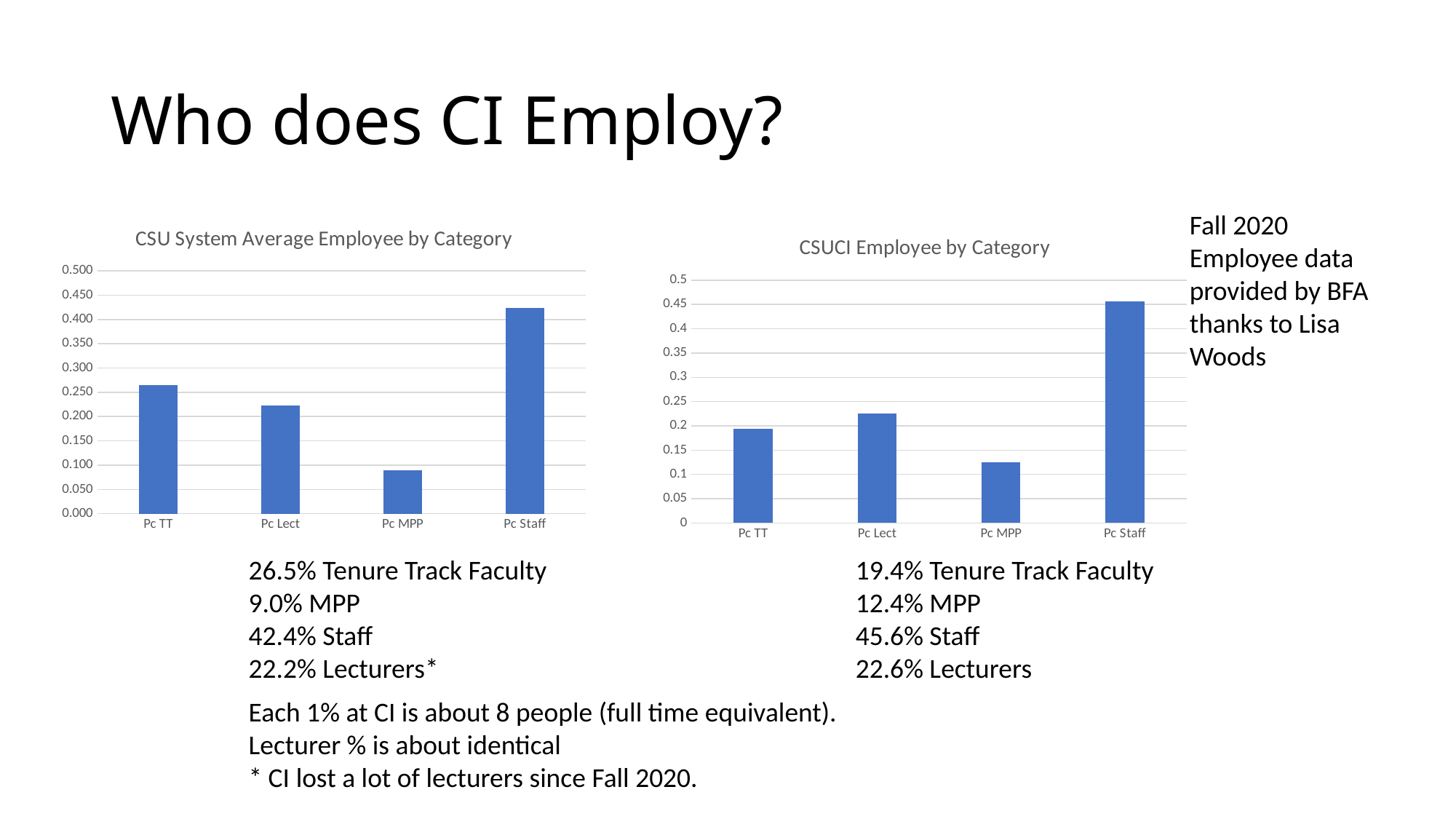
In the CSU System Average Employee by Category chart, which category has the lowest value? Pc MPP How many categories are shown in the CSUCI Employee by Category chart? 4 In the CSU System Average Employee by Category chart, which is larger, the value for Pc TT or the value for Pc Lect? Pc TT In the CSUCI Employee by Category chart, which is larger, the value for Pc TT or the value for Pc Lect? Pc Lect What type of chart is the CSU System Average Employee by Category chart? bar chart In the CSU System Average Employee by Category chart, is the value for Pc Staff greater or less than 0.400? greater In the CSU System Average Employee by Category chart, which category has the highest value? Pc Staff In the CSUCI Employee by Category chart, which category has the lowest value? Pc MPP What is the title of the chart on the right side of the slide? CSUCI Employee by Category In the CSUCI Employee by Category chart, is the value for Pc MPP greater or less than 0.1? greater In the CSUCI Employee by Category chart, which category has the highest value? Pc Staff